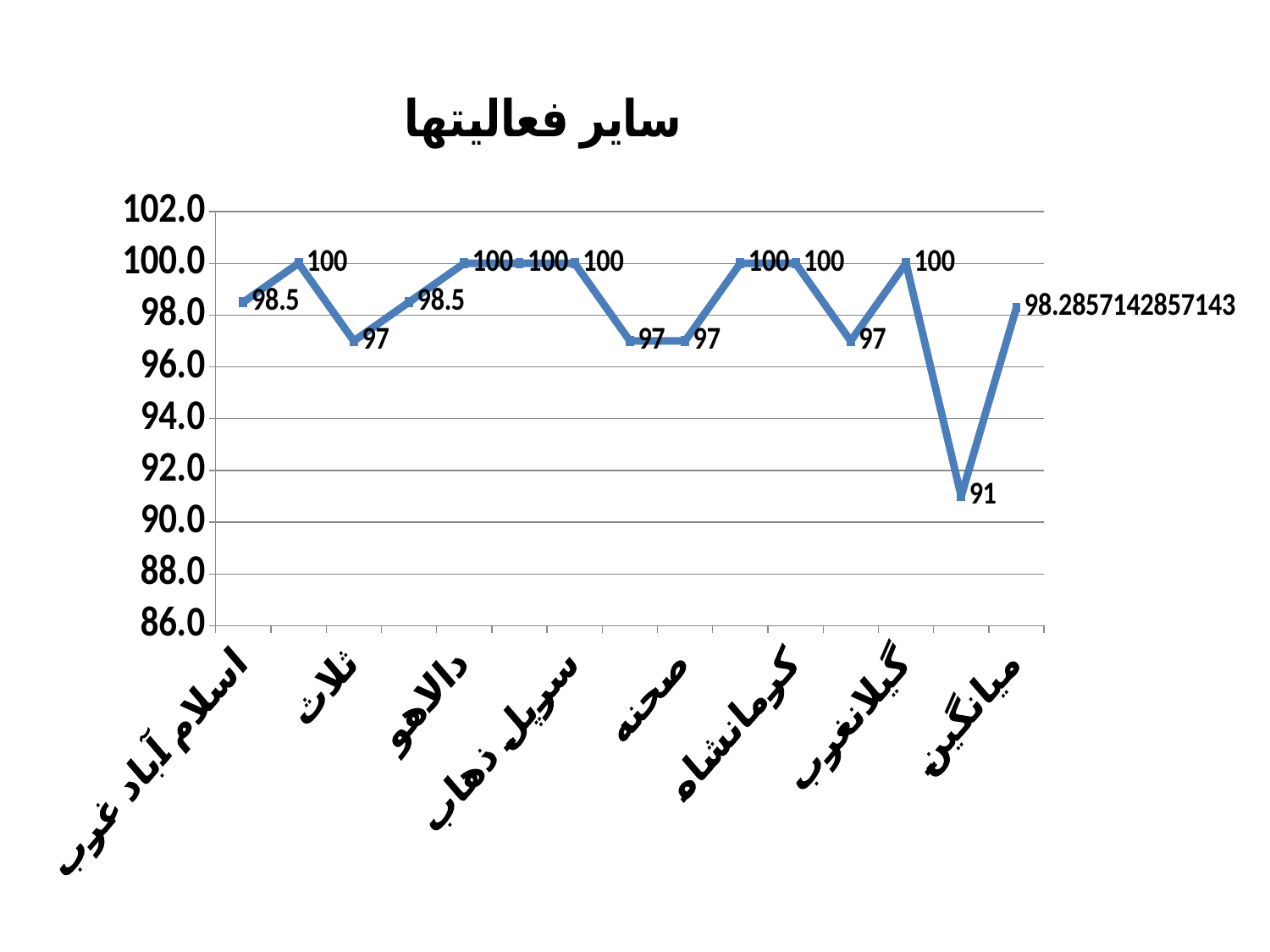
Is the value for میانگین greater or less than 98.0? greater What is the lowest value plotted on the chart? 91 What is the title of the chart? سایر فعالیتها What is the lowest value shown on the vertical axis? 86.0 What is the difference between the highest value (100) and the lowest value (91) on the chart? 9 How many data points are plotted on the line? 15 What type of chart is shown on the slide? line chart What is the value for میانگین? 98.2857142857143 What is the highest value plotted on the chart? 100 Is the lowest point on the chart greater or less than 92.0? less What is the value for اسلام آباد غرب? 98.5 Which is larger, the value for اسلام آباد غرب or the value for میانگین? اسلام آباد غرب